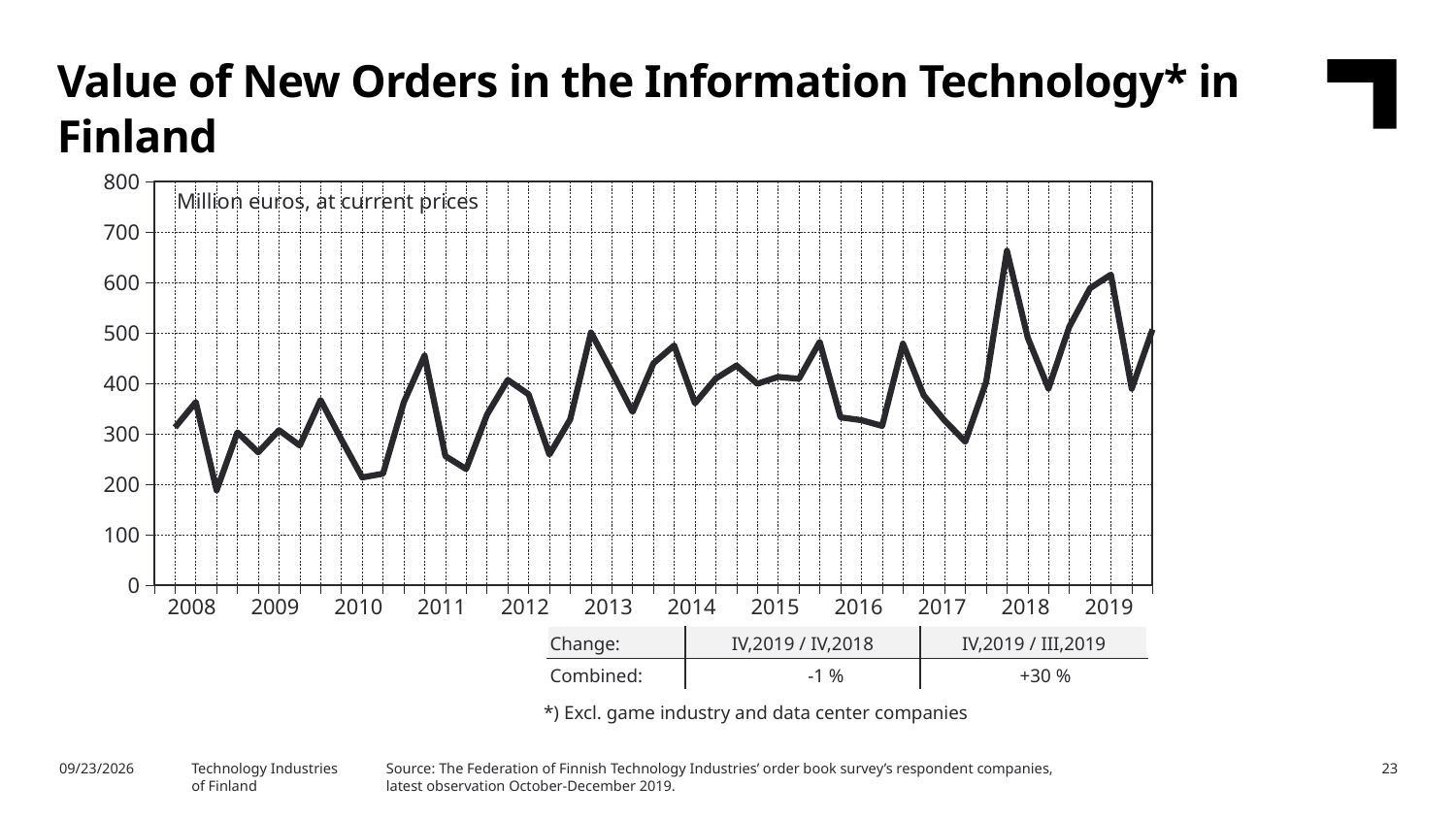
In what unit are the values on the chart expressed, according to the label inside the plot area? Million euros, at current prices How many years are labelled on the x axis of the chart? 12 In which year does the line reach its highest point? 2018 Is the highest value of the line, reached in 2018, greater or less than 600? greater What kind of chart is shown on the slide? line chart In which year does the line reach its lowest point? 2008 Does the line rise or fall between its low point in 2017 and its peak in 2018? rises According to the change table below the chart, what is the combined change for IV,2019 / III,2019? +30 % What is the title of the chart? Value of New Orders in the Information Technology* in Finland Is the peak of the line in 2011 greater or less than 400? greater Is the lowest value of the line, reached in 2008, greater or less than 200? less